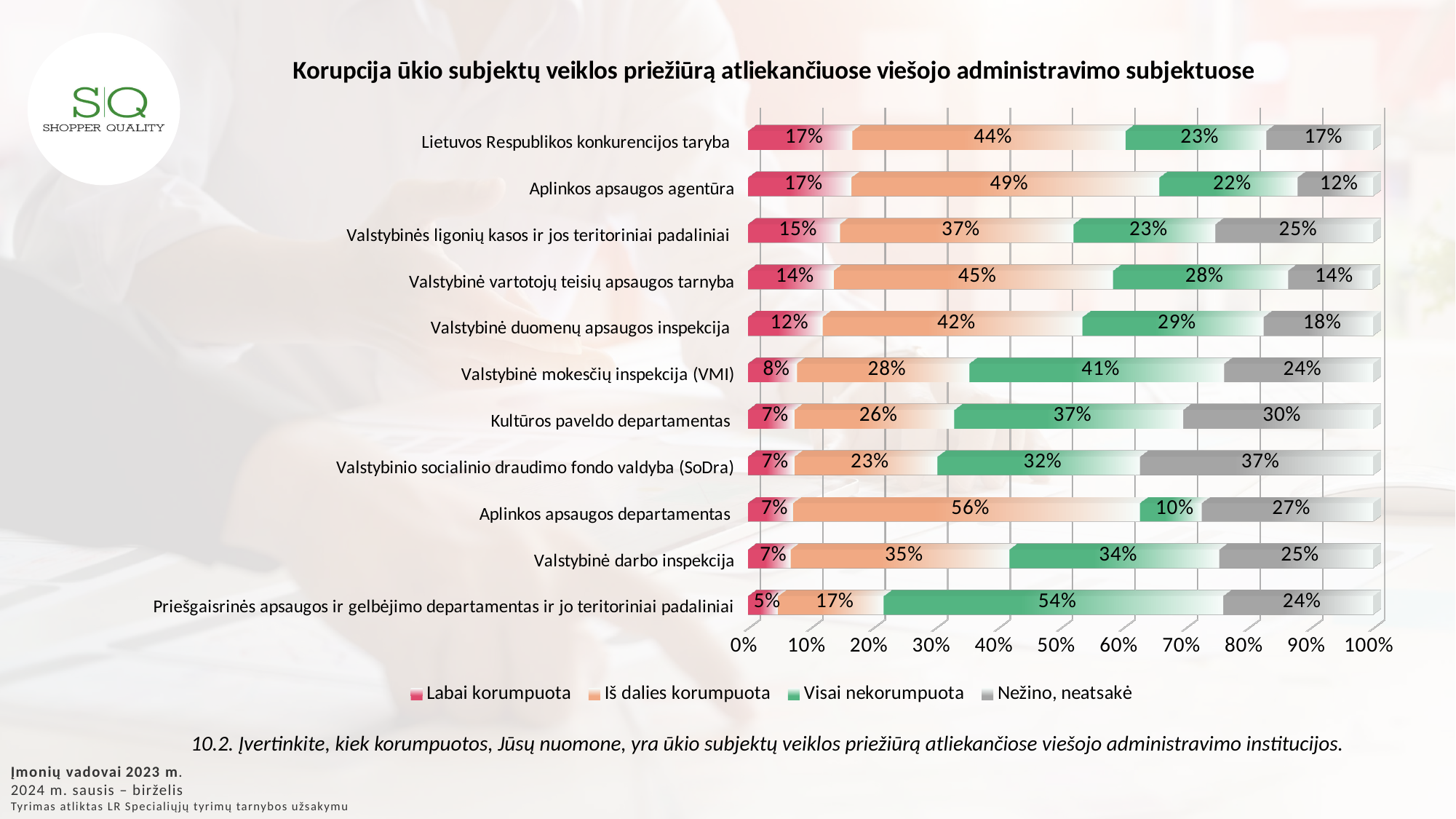
Which institution has the lowest "Labai korumpuota" share? Priešgaisrinės apsaugos ir gelbėjimo departamentas ir jo teritoriniai padaliniai What type of chart is shown on the slide? Stacked bar chart What is the combined share of "Labai korumpuota" and "Iš dalies korumpuota" for Kultūros paveldo departamentas? 33% Which institution has the highest "Iš dalies korumpuota" share? Aplinkos apsaugos departamentas What is the "Iš dalies korumpuota" value for Aplinkos apsaugos agentūra? 49% What is the "Nežino, neatsakė" value for Valstybinio socialinio draudimo fondo valdyba (SoDra)? 37% Which has a larger "Labai korumpuota" share: Lietuvos Respublikos konkurencijos taryba or Valstybinė duomenų apsaugos inspekcija? Lietuvos Respublikos konkurencijos taryba How many institutions are shown in the chart? 11 How many series does the legend list? 4 What is the difference between the "Visai nekorumpuota" values for Valstybinė darbo inspekcija and Aplinkos apsaugos departamentas? 24% Which institution has the highest "Visai nekorumpuota" share? Priešgaisrinės apsaugos ir gelbėjimo departamentas ir jo teritoriniai padaliniai What percentage of respondents rated Valstybinė mokesčių inspekcija (VMI) as "Visai nekorumpuota"? 41%